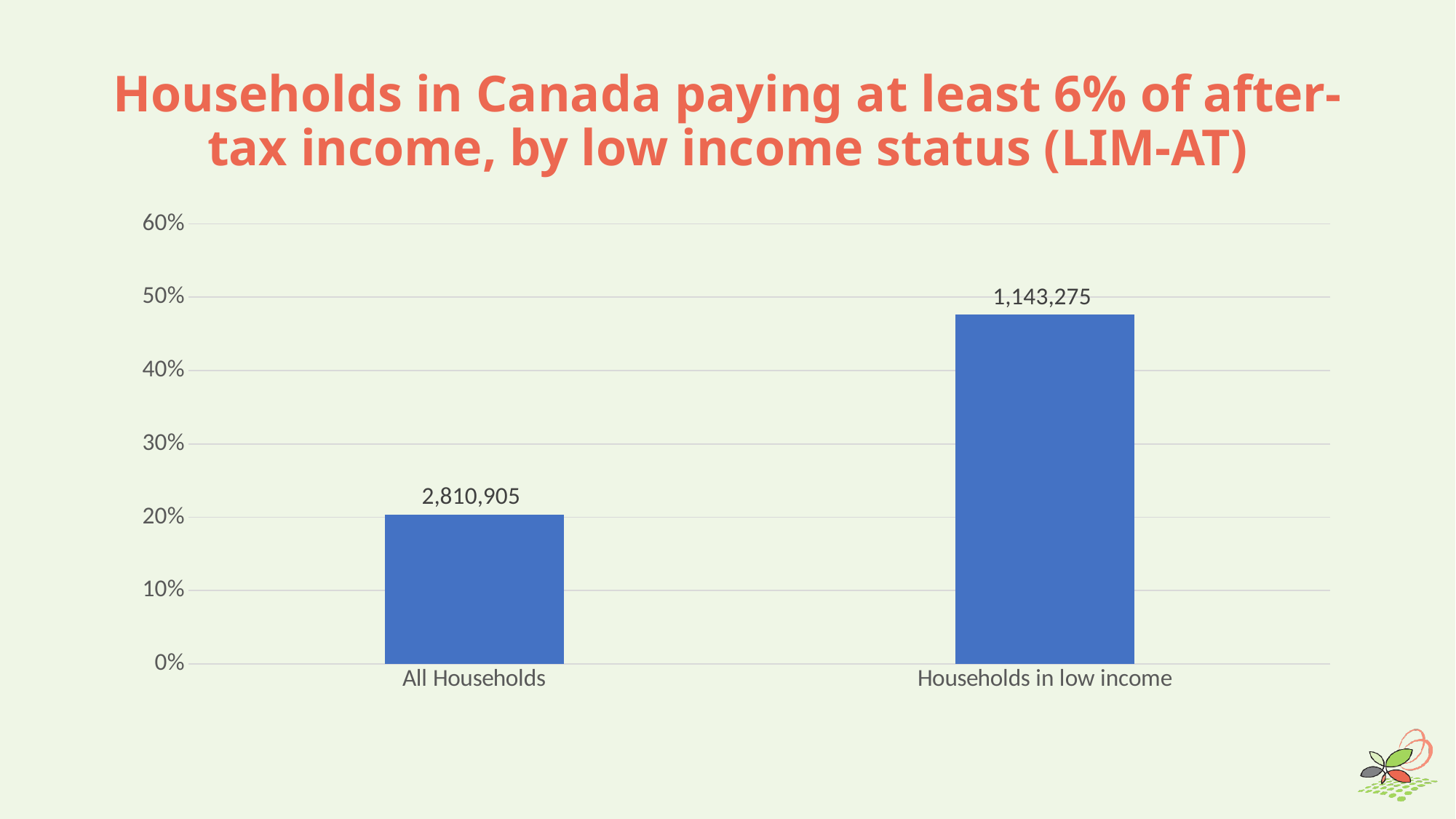
What is the highest value labelled on the vertical axis? 60% Is the bar for Households in low income greater or less than 50% on the axis? less What data label is shown above the bar for All Households? 2,810,905 What kind of chart is shown on the slide? bar chart Which category has the shorter bar? All Households Which category has the taller bar? Households in low income Is the bar for All Households greater or less than 30% on the axis? less Is the bar for Households in low income taller or shorter than the bar for All Households? taller What is the title of the chart? Households in Canada paying at least 6% of after-tax income, by low income status (LIM-AT) How many categories are shown on the x axis? 2 What data label is shown above the bar for Households in low income? 1,143,275 Is the bar for Households in low income greater or less than 40% on the axis? greater